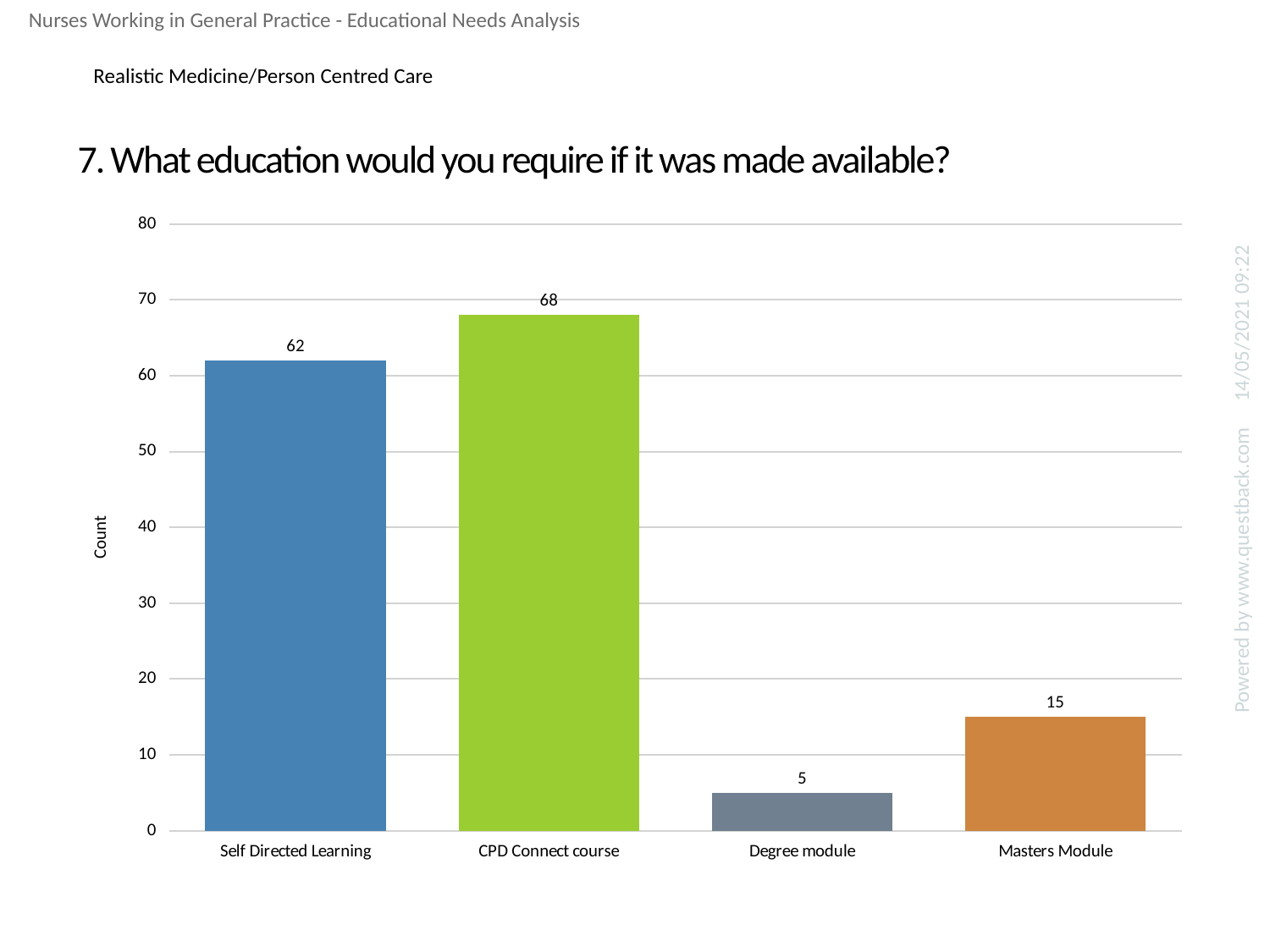
What is the count for CPD Connect course? 68 What is the difference between the counts for CPD Connect course and Self Directed Learning? 6 What is the difference between the counts for Masters Module and Degree module? 10 Which has a larger count, Self Directed Learning or Masters Module? Self Directed Learning What is the count for Self Directed Learning? 62 What is the count for Degree module? 5 Which category has the highest count? CPD Connect course How many categories are shown on the x axis? 4 What is the count for Masters Module? 15 What kind of chart is shown on the slide? Bar chart Which category has the lowest count? Degree module What is the label of the y axis? Count